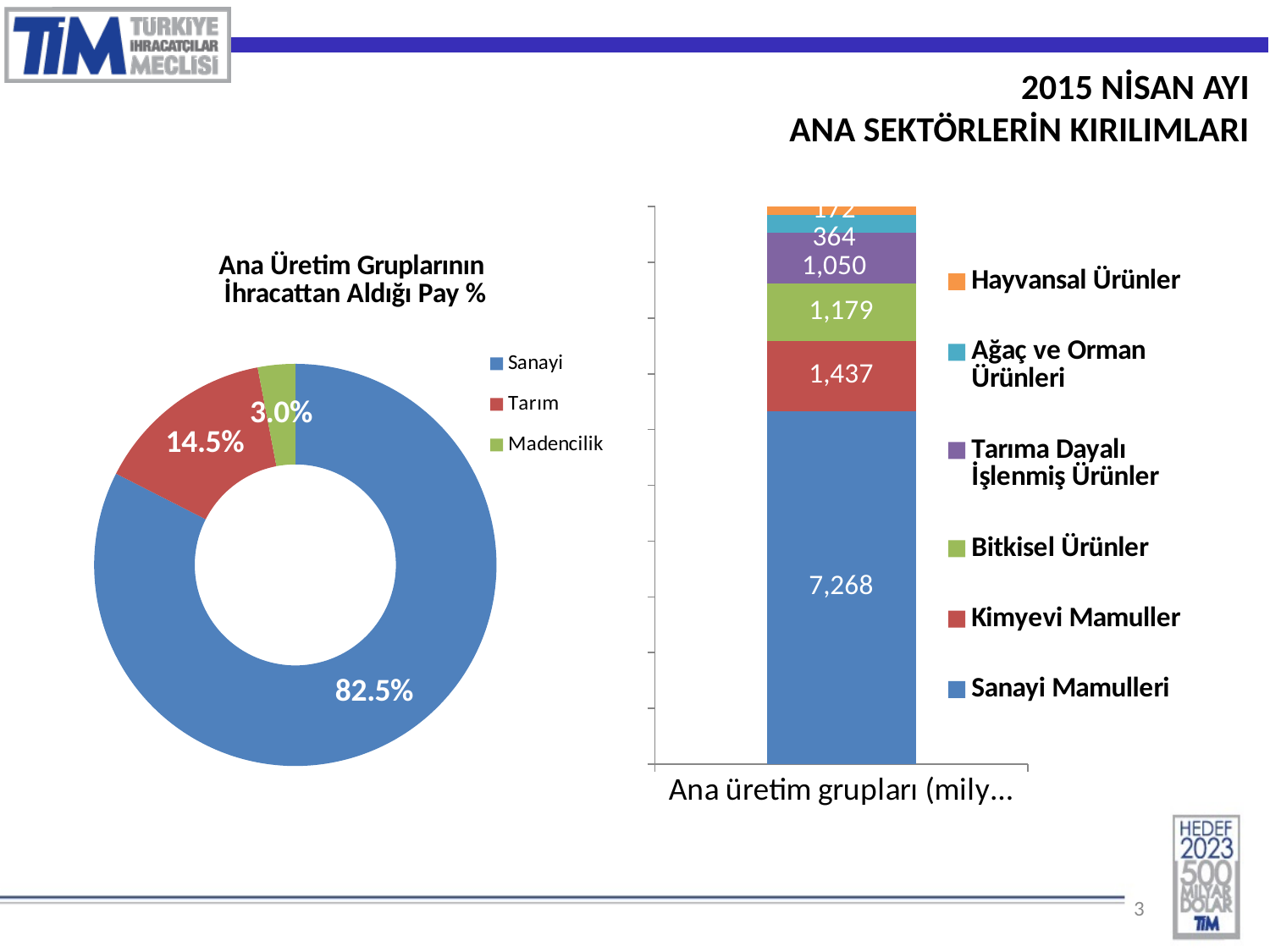
In the doughnut chart on the left, which category has the smallest share? Madencilik In the stacked bar chart on the right, what is the value for Sanayi Mamulleri? 7,268 In the stacked bar chart on the right, what is the difference between Kimyevi Mamuller and Bitkisel Ürünler? 258 In the doughnut chart on the left, how many categories does the legend list? 3 In the doughnut chart on the left, which category has the largest share? Sanayi In the doughnut chart titled 'Ana Üretim Gruplarının İhracattan Aldığı Pay %', what share does Sanayi have? 82.5% In the stacked bar chart on the right, how many series does the legend list? 6 In the doughnut chart on the left, what share does Tarım have? 14.5% In the stacked bar chart on the right, what is the value for Kimyevi Mamuller? 1,437 In the stacked bar chart on the right, what is the value for Tarıma Dayalı İşlenmiş Ürünler? 1,050 In the stacked bar chart on the right, what is the value for Bitkisel Ürünler? 1,179 In the doughnut chart on the left, what share does Madencilik have? 3.0%